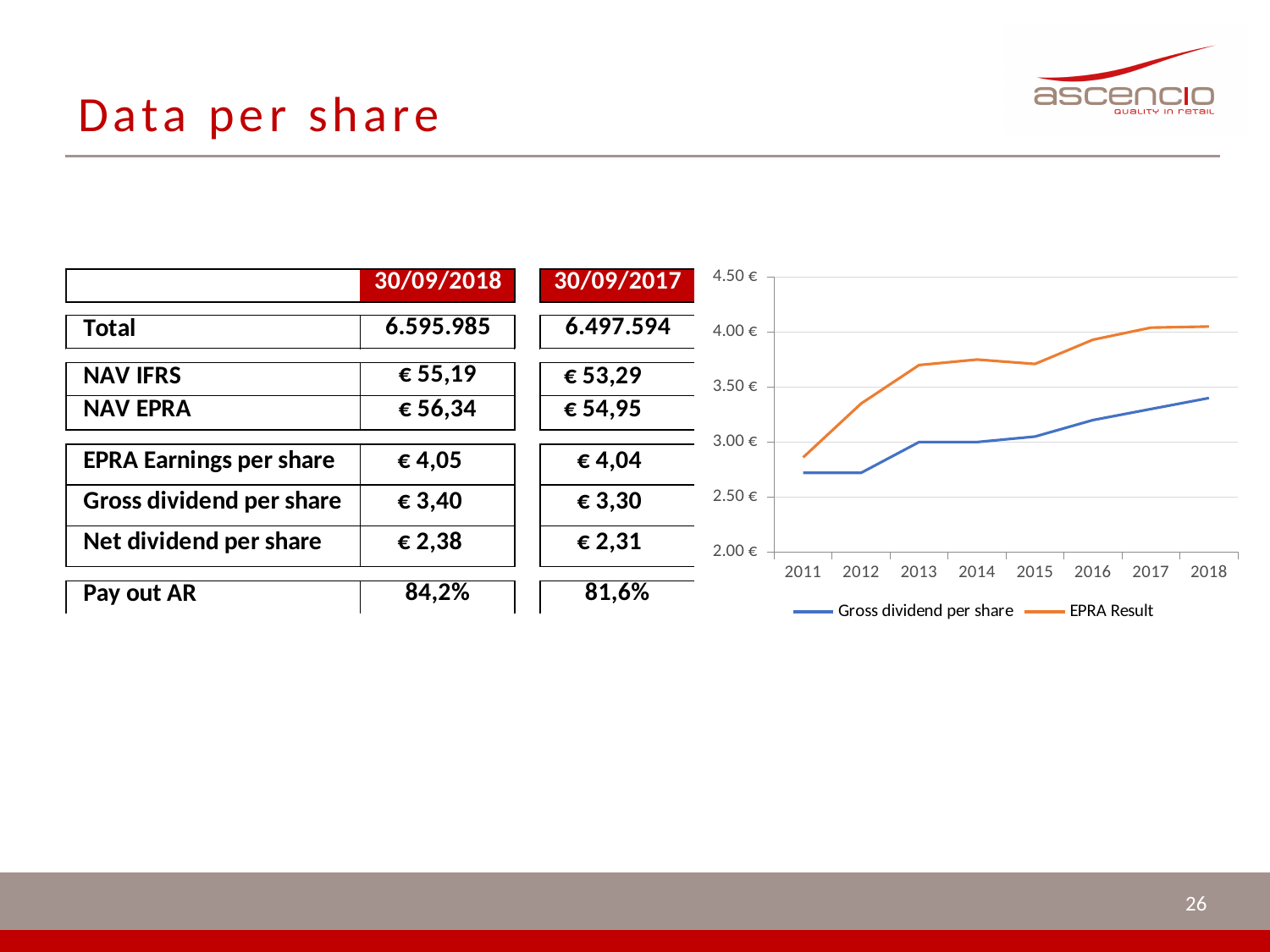
In 2015, which is larger: EPRA Result or Gross dividend per share? EPRA Result How many series does the chart legend list? 2 Does the Gross dividend per share line generally rise or fall from 2011 to 2018? rise In which year is the Gross dividend per share line at its highest? 2018 Is the value for Gross dividend per share in 2011 greater or less than 3.00 €? less Is the value for Gross dividend per share in 2016 greater or less than 3.00 €? greater Is the value for EPRA Result in 2013 greater or less than 3.50 €? greater How many years are plotted along the x axis of the chart? 8 Which two series are listed in the chart legend? Gross dividend per share and EPRA Result In which year is the EPRA Result line at its lowest? 2011 What colour is the EPRA Result line in the chart? orange What kind of chart is shown on the right of the slide? line chart